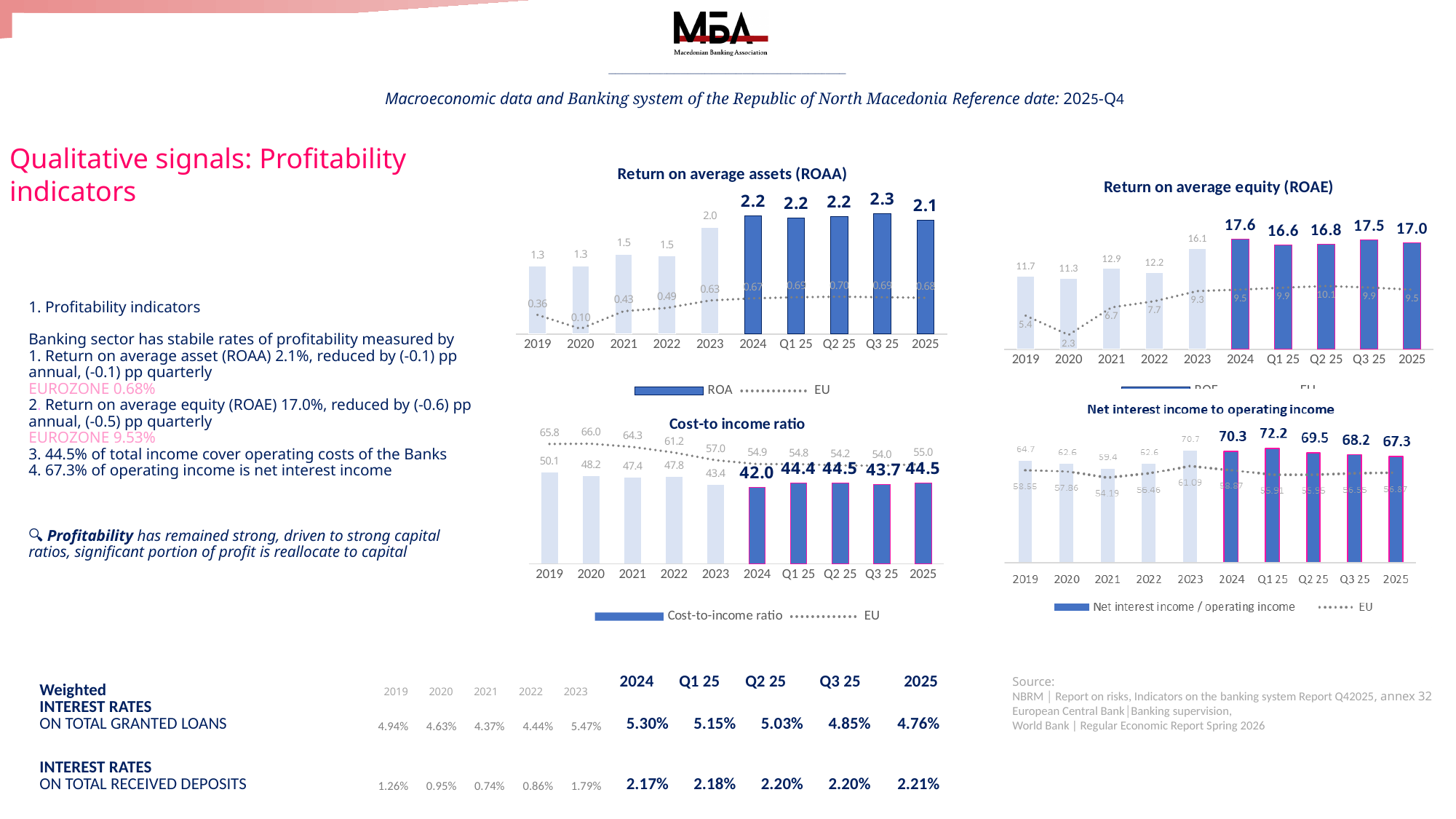
In the Cost-to income ratio chart, which is larger for 2019: the Cost-to-income ratio or the EU value? EU In the Net interest income to operating income chart, which period has the highest bar? Q1 25 In the Return on average assets (ROAA) chart, what is the ROA value for 2025? 2.1 In the Return on average equity (ROAE) chart, which year has the lowest EU value? 2020 In the Net interest income to operating income chart, what is the value for 2025? 67.3 In the Cost-to income ratio chart, what is the EU value for 2025? 55.0 In the Return on average equity (ROAE) chart, what is the value for 2024? 17.6 In the Return on average assets (ROAA) chart, what is the EU value for 2020? 0.10 In the Cost-to income ratio chart, what is the Cost-to-income ratio for 2024? 42.0 In the Return on average equity (ROAE) chart, what is the difference between the 2024 value and the 2025 value? 0.6 How many periods are shown on the x axis of the Return on average assets (ROAA) chart? 10 In the Return on average assets (ROAA) chart, which period has the highest ROA bar? Q3 25